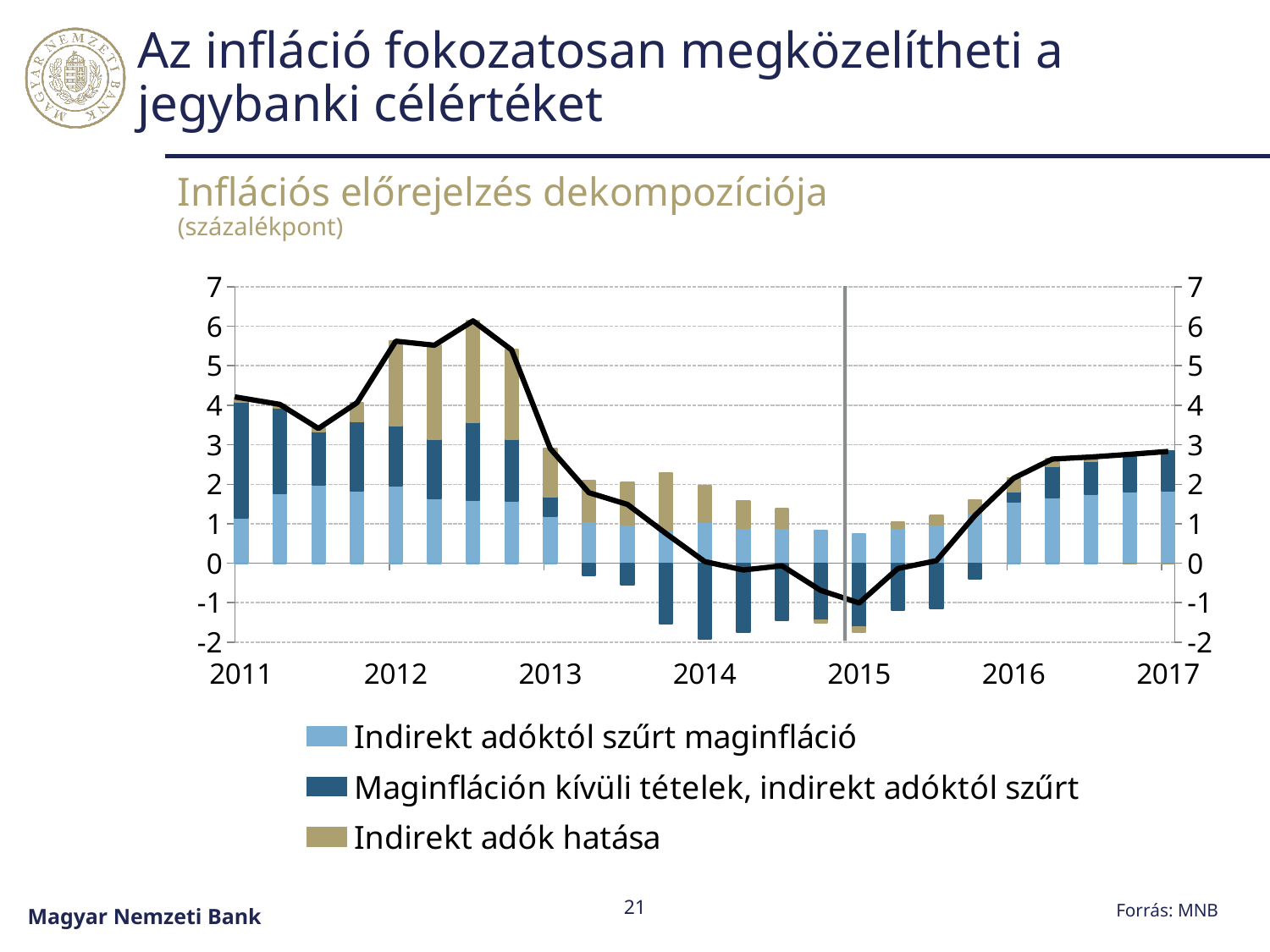
Is the value of the black line at 2017 greater or less than 2? greater Does the black line rise or fall between 2015 and 2017? rise Is the value of the black line at the start of 2015 greater or less than 0? less What unit is given in parentheses under the chart title? százalékpont In which year does the black line reach its highest point? 2012 In which year does the black line reach its lowest point? 2015 What is the title of the chart? Inflációs előrejelzés dekompozíciója Is the value of the black line at the start of 2011 greater or less than 3? greater What kind of chart is shown on the slide? Stacked bar chart with a line How many series does the legend list? 3 How many year labels are shown on the x axis? 7